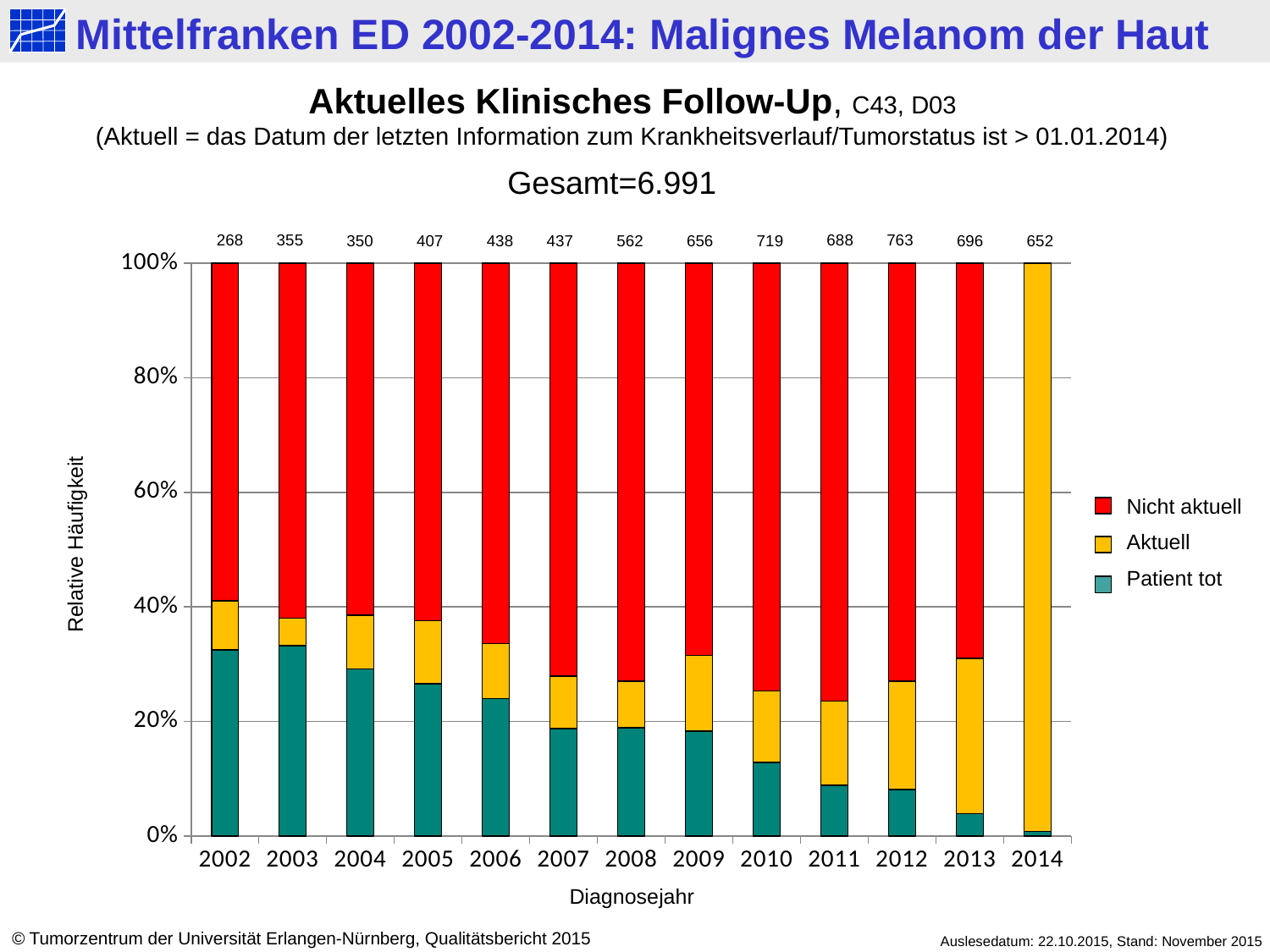
Which diagnosis year has the lowest number of cases printed above its bar? 2002 Which diagnosis year has the highest number of cases printed above its bar? 2012 Which year has the larger case count printed above its bar, 2010 or 2011? 2010 Is the share of 'Patient tot' in 2002 greater or less than 20%? greater Is the share of 'Aktuell' in 2014 greater or less than 80%? greater What is the difference between the case counts printed for 2012 and 2002? 495 What kind of chart is shown on the slide? stacked bar chart What is the number of cases printed above the bar for 2002? 268 How many diagnosis years are shown on the x axis? 13 How many series does the legend list? 3 What is the number of cases printed above the bar for 2014? 652 What is the number of cases printed above the bar for 2012? 763